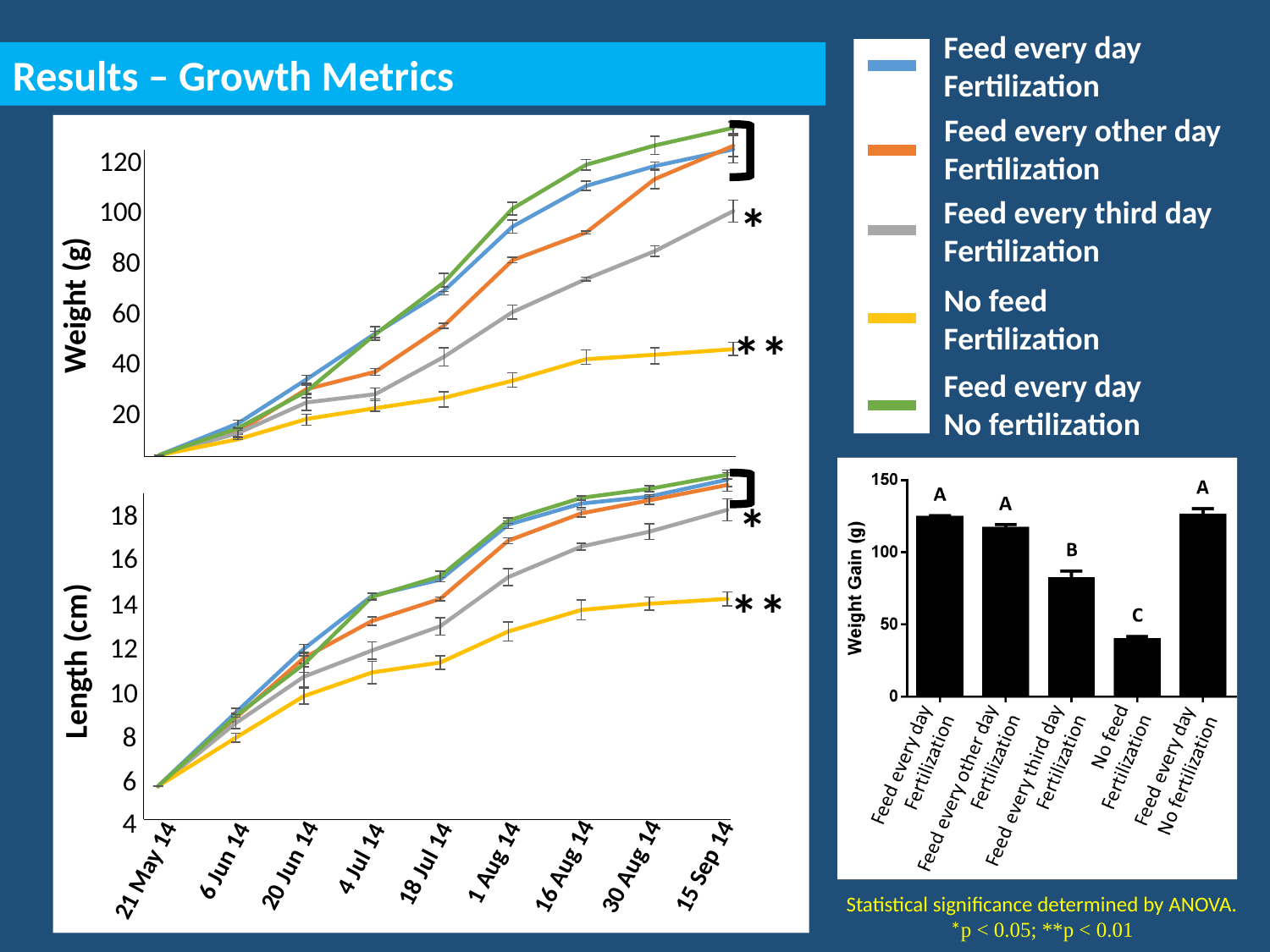
In the Length (cm) chart, is the value for No feed Fertilization on 15 Sep 14 greater or less than 16? less How many series does the legend list for the line charts? 5 In the Weight (g) chart, how many dates are shown on the x axis? 9 What kind of chart is the Weight Gain (g) chart? bar chart In the Weight (g) chart, is the value for No feed Fertilization on 15 Sep 14 greater or less than 60? less In the Length (cm) chart, which series has the lowest length on 15 Sep 14? No feed Fertilization In the Weight (g) chart, do the values rise or fall from 21 May 14 to 15 Sep 14? rise In the Weight (g) chart, is the value for Feed every third day Fertilization on 15 Sep 14 greater or less than 80? greater In the Weight Gain (g) chart, which category has the lowest weight gain? No feed Fertilization In the Weight (g) chart, which series has the lowest weight on 15 Sep 14? No feed Fertilization In the Weight Gain (g) chart, which is larger: Feed every other day Fertilization or Feed every third day Fertilization? Feed every other day Fertilization